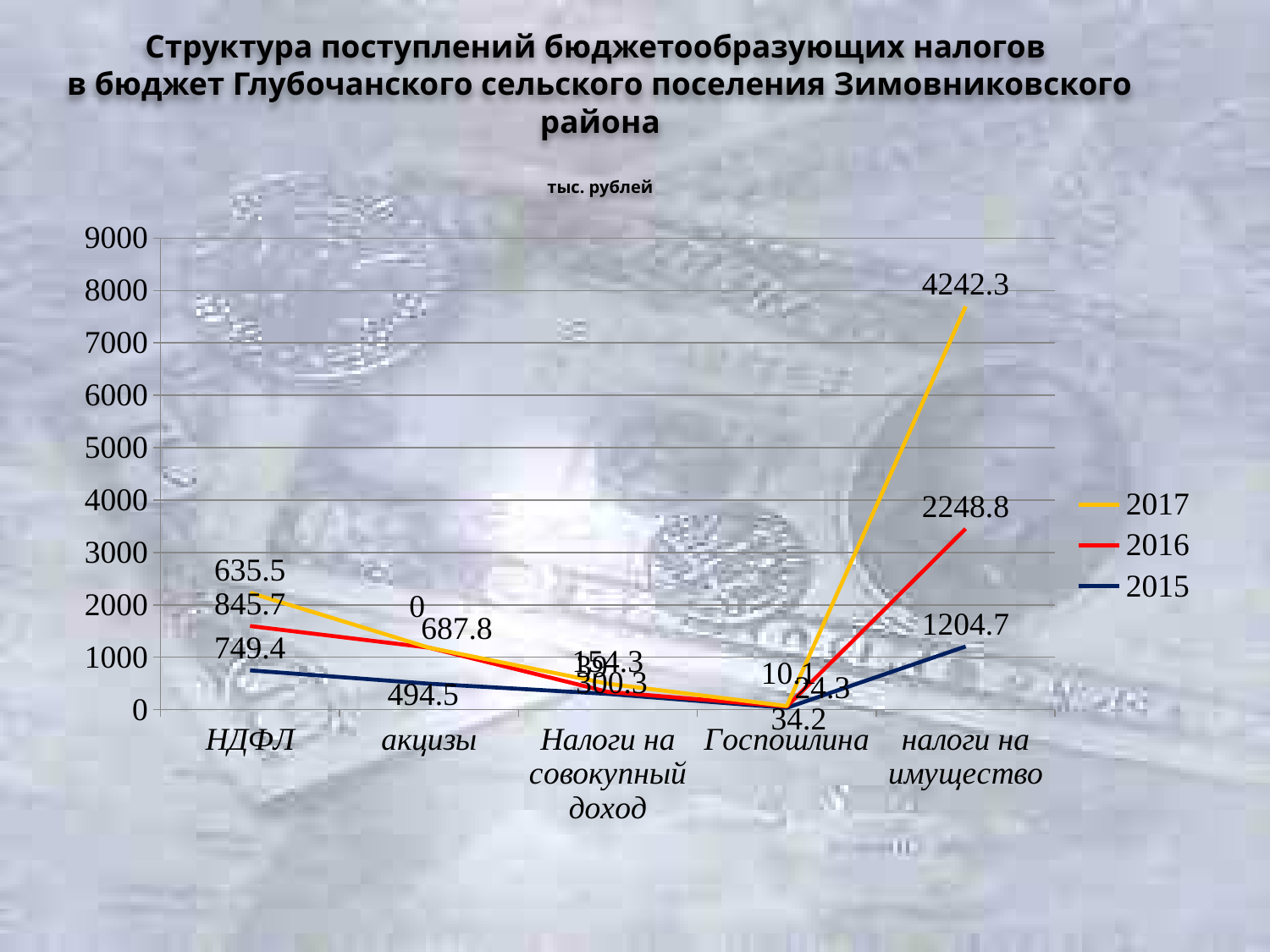
How many categories are shown on the x axis? 5 What is the 2015 value for налоги на имущество? 1204.7 What is the difference between the 2017 and 2016 values for налоги на имущество? 1993.5 For налоги на имущество, which is larger: the 2017 value or the 2016 value? 2017 What kind of chart is shown on the slide? line chart Which category has the lowest value for the 2015 series? Госпошлина How many series does the legend list? 3 Which category has the highest value for the 2017 series? налоги на имущество What is the 2016 value for налоги на имущество? 2248.8 What unit is stated for the values on the chart? тыс. рублей Which years are listed in the legend? 2017, 2016, 2015 What is the 2017 value for налоги на имущество? 4242.3